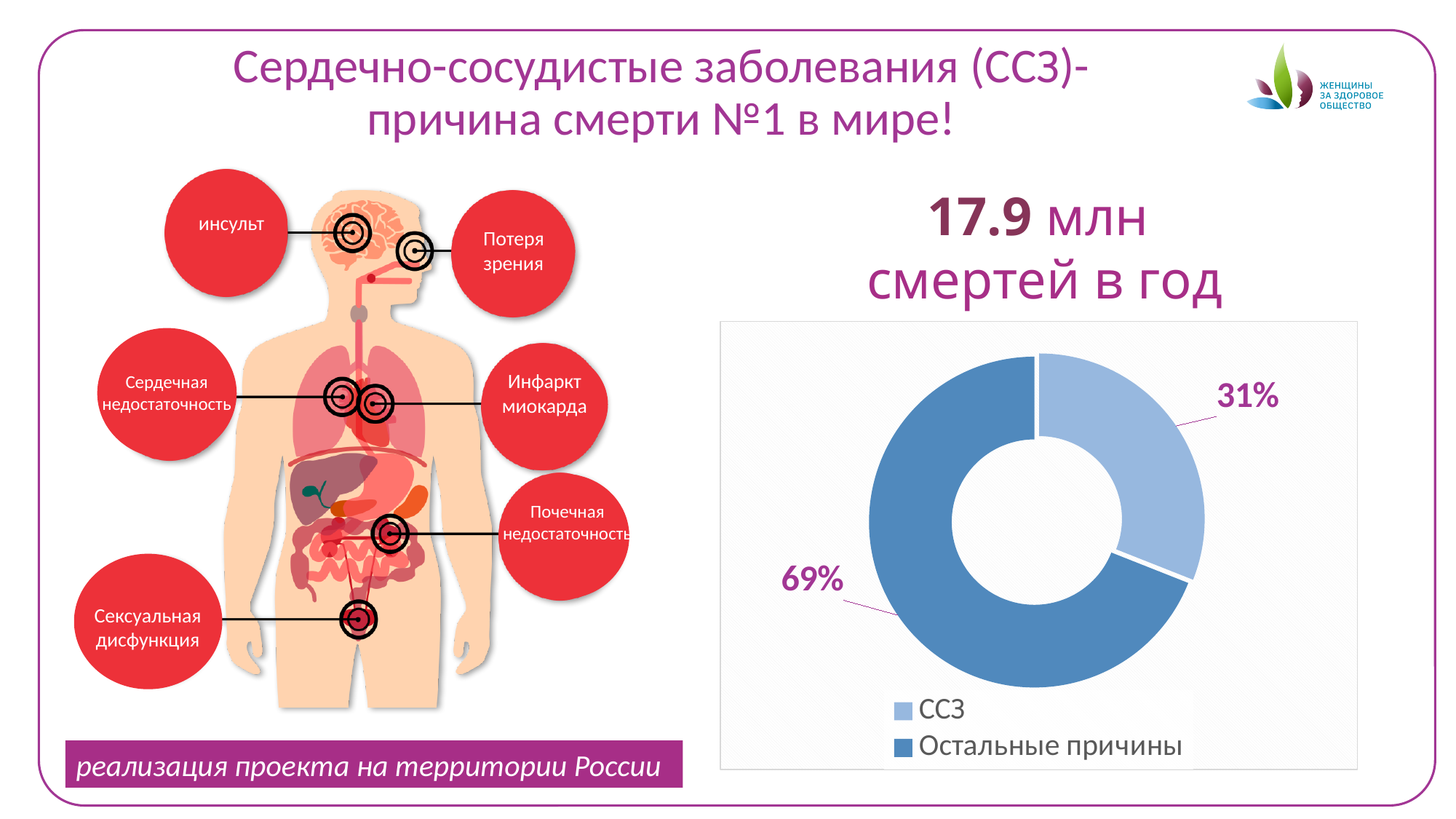
Which is larger in the doughnut chart: ССЗ or Остальные причины? Остальные причины Which slice of the doughnut chart is the largest? Остальные причины How many slices does the doughnut chart have? 2 What share of the doughnut chart is labelled ССЗ? 31% How many entries does the legend of the doughnut chart list? 2 What kind of chart is shown on the right side of the slide? doughnut chart Which slice of the doughnut chart is the smallest? ССЗ Which legend entry of the doughnut chart is shown in the lighter blue colour? ССЗ What number of deaths per year is stated above the doughnut chart? 17.9 млн What is the difference in percentage points between the Остальные причины slice and the ССЗ slice? 38 What share of the doughnut chart is labelled Остальные причины? 69% What is the total of the two percentages shown on the doughnut chart? 100%